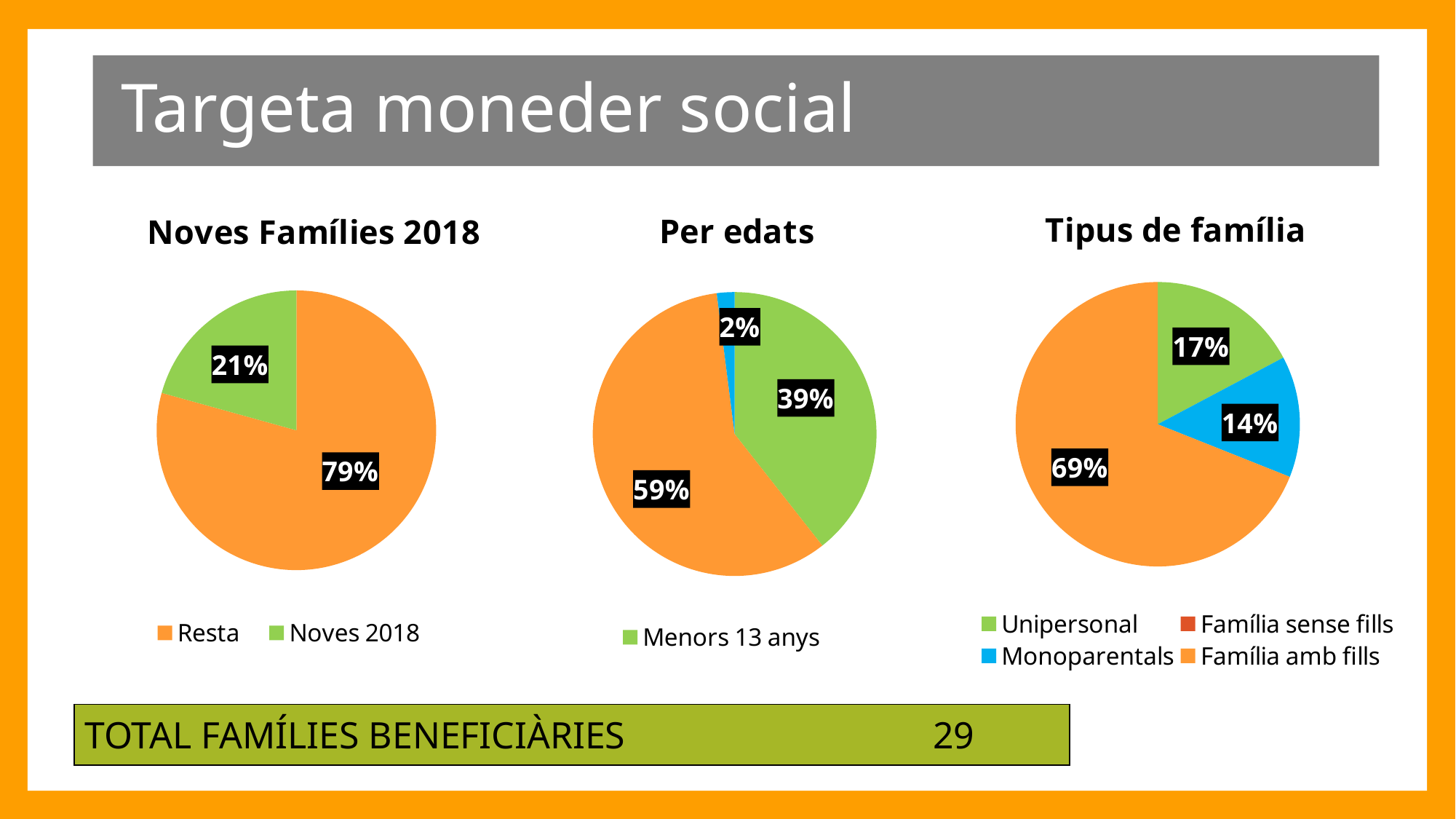
In the 'Per edats' chart, how many slices does the pie have? 3 In the 'Tipus de família' chart, what share does 'Unipersonal' have? 17% In the 'Noves Famílies 2018' chart, what share does 'Resta' have? 79% In the 'Tipus de família' chart, which is larger, 'Unipersonal' or 'Monoparentals'? Unipersonal In the 'Tipus de família' chart, which category has the largest slice? Família amb fills In the 'Per edats' chart, what is the value of the largest slice? 59% In the 'Noves Famílies 2018' chart, which category has the largest slice? Resta In the 'Per edats' chart, what share does 'Menors 13 anys' have? 39% What type of chart is 'Tipus de família'? Pie chart In the 'Noves Famílies 2018' chart, what share does 'Noves 2018' have? 21% In the 'Tipus de família' chart, what share does 'Monoparentals' have? 14% In the 'Noves Famílies 2018' chart, what is the difference in percentage points between 'Resta' and 'Noves 2018'? 58